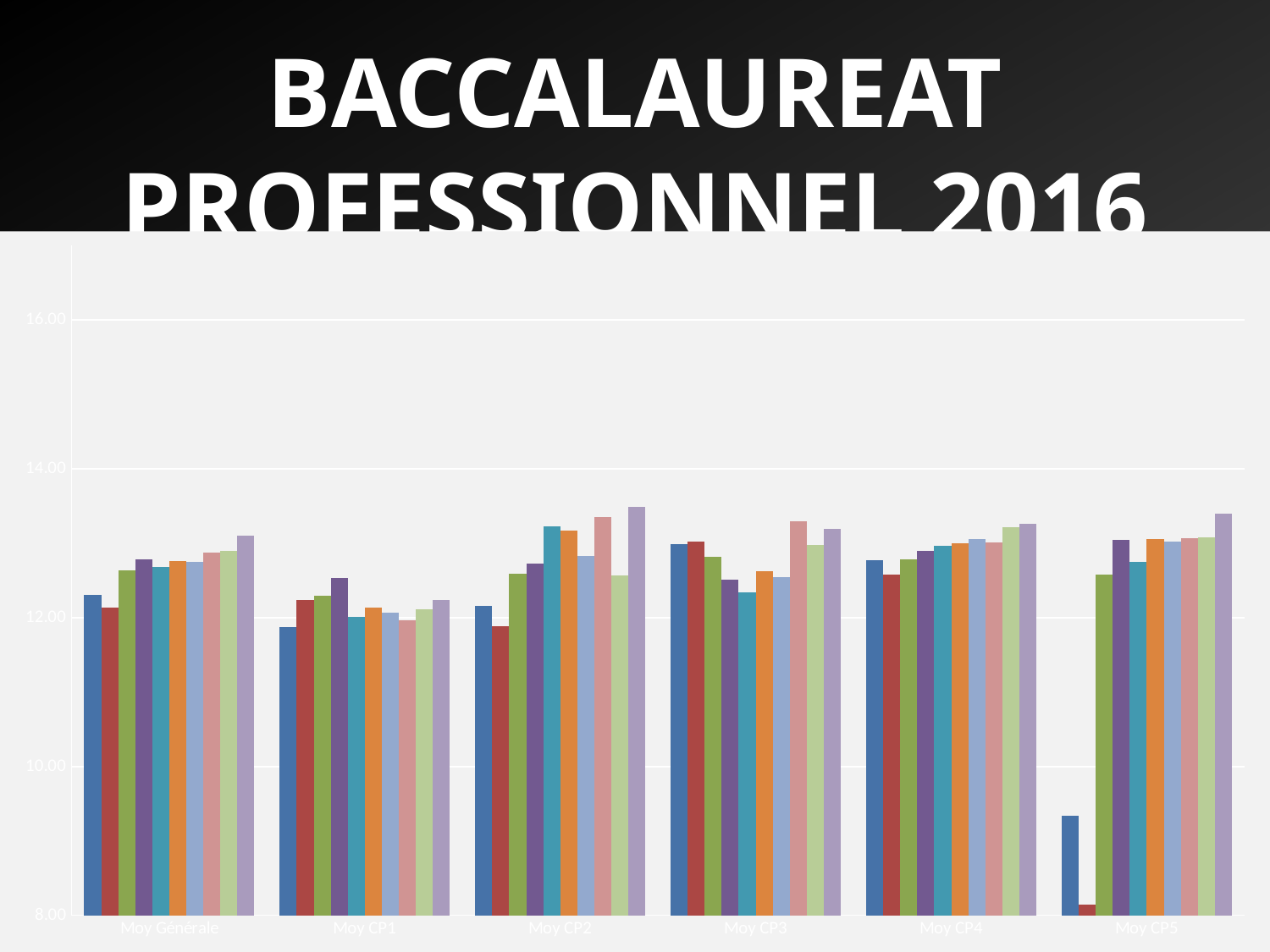
Is the shortest bar in the Moy CP4 group greater or less than 12.00? greater What kind of chart is shown on the slide? bar chart Is the tallest bar in the Moy CP2 group greater or less than 14.00? less What is the highest value shown on the chart's y axis? 16.00 Is the value of the first (blue) bar for Moy CP5 greater or less than 10.00? less How many categories are shown on the x axis of the chart? 6 What is the title of the slide containing the chart? BACCALAUREAT PROFESSIONNEL 2016 How many bars are plotted for the Moy Générale category? 10 Which category contains the lowest bar on the chart? Moy CP5